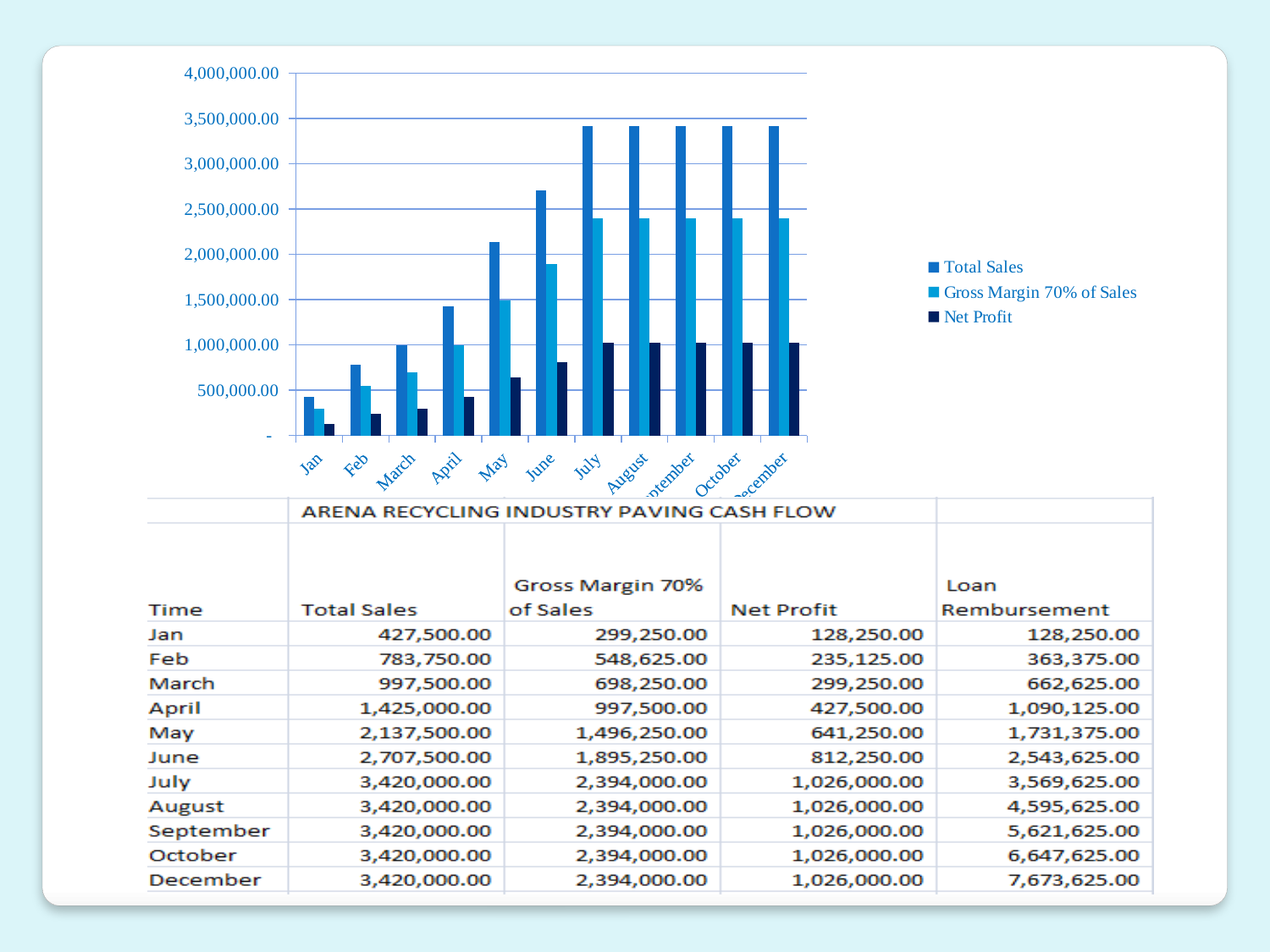
What is the Gross Margin 70% of Sales value for March? 698,250.00 Do the Total Sales values rise or fall from Jan to July? rise What is the difference between Total Sales in June and Total Sales in May? 570,000.00 What is the Total Sales value for May? 2,137,500.00 Is the Total Sales value for April greater or less than 1,500,000.00? less What is the Net Profit value for June? 812,250.00 Which is larger, Total Sales for Feb or Total Sales for March? March How many series does the chart legend list? 3 Is the Total Sales value for June greater or less than 2,500,000.00? greater How many months are plotted along the x axis of the chart? 11 What kind of chart is shown on the slide? bar chart Which month has the lowest Total Sales? Jan